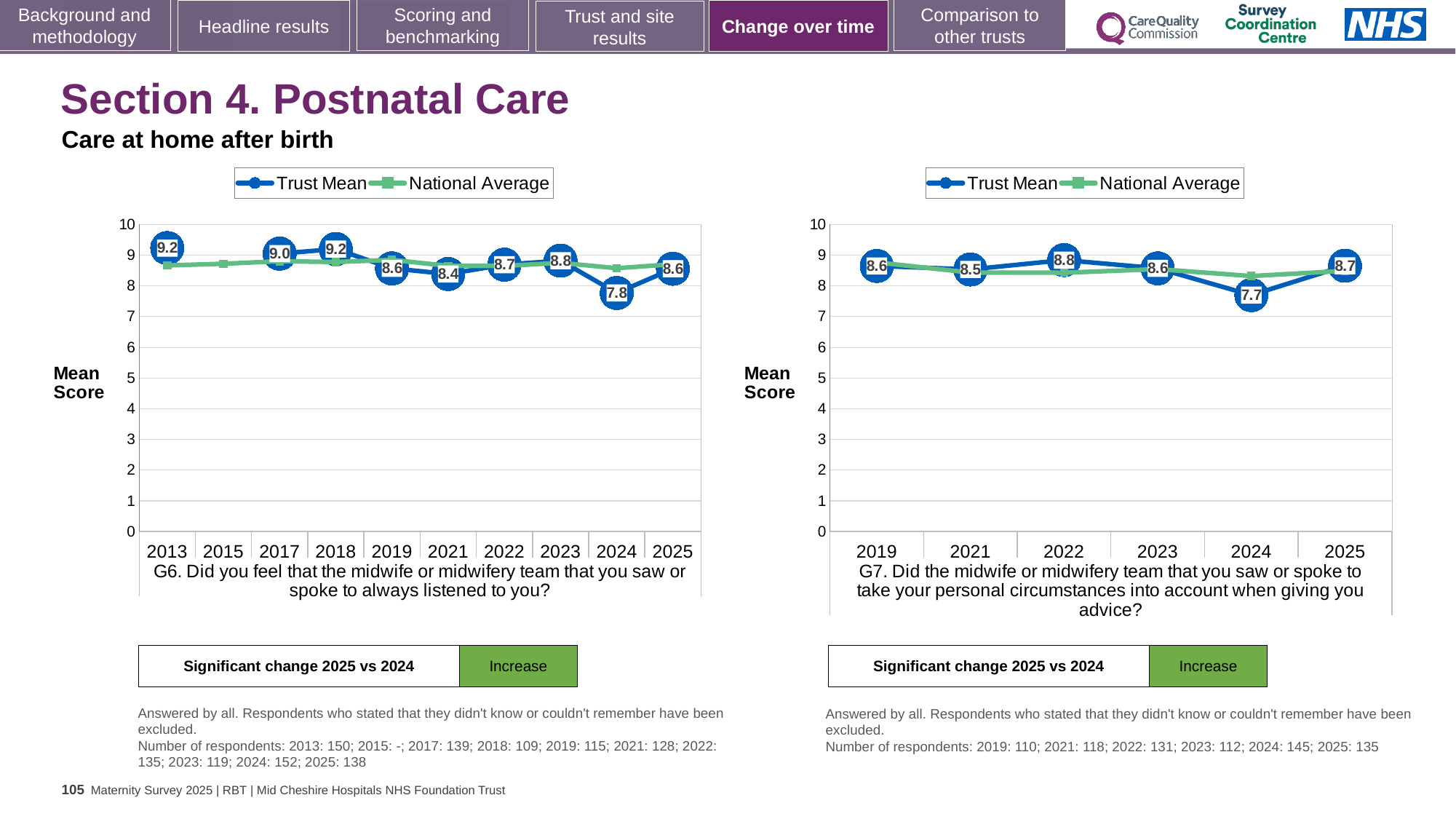
In the left chart (G6), what is the Trust Mean for 2025? 8.6 In the right chart (G7), which year has the highest Trust Mean? 2022 In the right chart (G7), which year has the lowest Trust Mean? 2024 How many years are shown on the x axis of the right chart (G7)? 6 In the right chart (G7), what is the Trust Mean for 2022? 8.8 How many series does the legend of the left chart (G6) list? 2 In the left chart (G6), which is larger, the Trust Mean for 2013 or for 2021? 2013 In the left chart (G6), what is the difference between the Trust Mean in 2025 and in 2024? 0.8 What type of chart is used for the G6 question on the left? Line chart In the right chart (G7), what is the difference between the Trust Mean in 2025 and in 2024? 1.0 In the left chart (G6), is the National Average for 2024 greater or less than 8? greater In the left chart (G6), what is the Trust Mean for 2024? 7.8